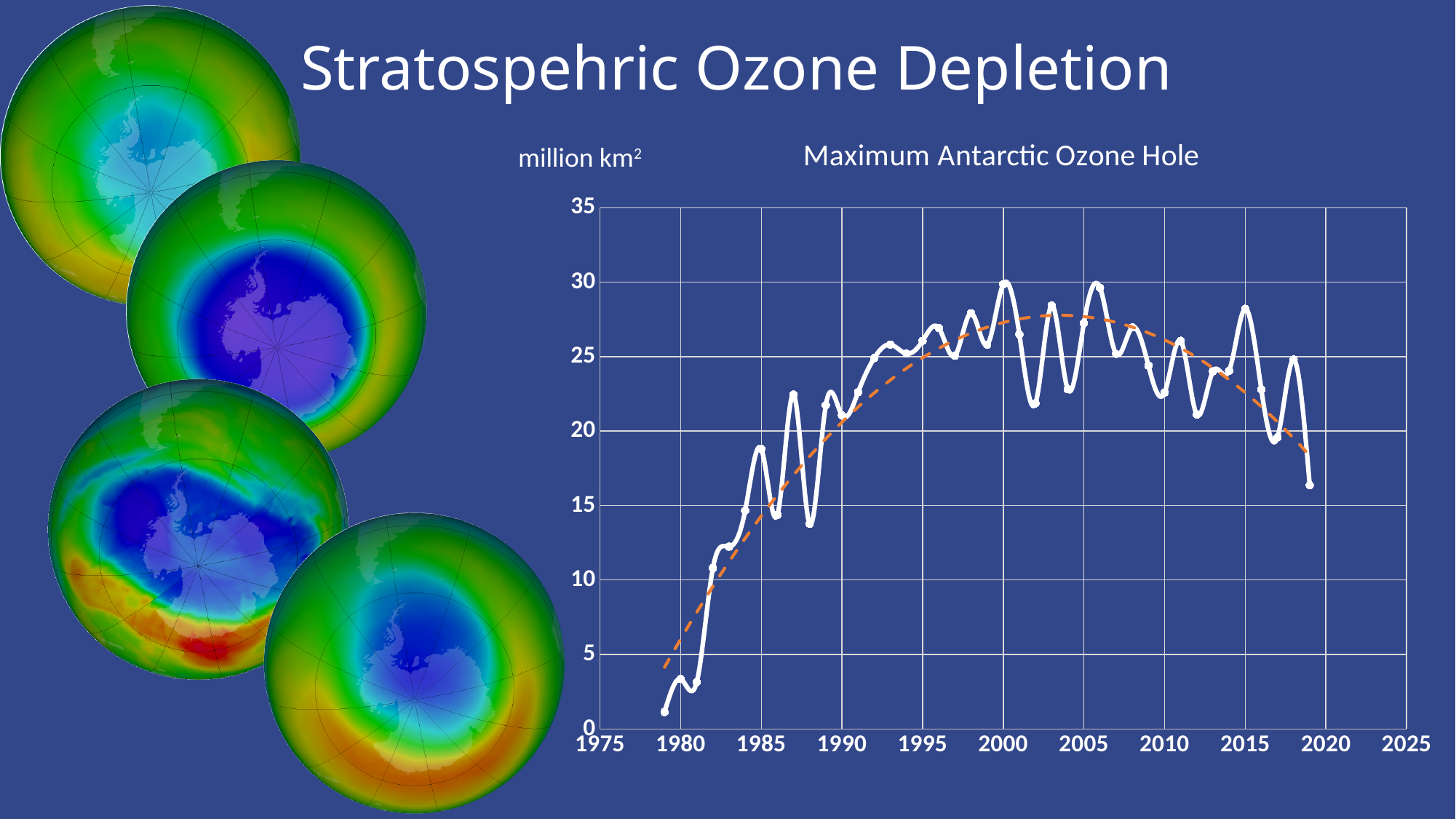
What kind of chart is shown on the slide? line chart Is the value for 1988 greater or less than 15? less Do the values generally rise or fall between 1979 and 2000? rise Is the value for 2006 greater or less than 25? greater What unit is shown for the vertical axis of the chart? million km² Is the value for 2015 greater or less than 25? greater Do the values generally rise or fall between 2006 and 2019? fall Which year has the lowest value on the chart? 1979 What is the title of the chart? Maximum Antarctic Ozone Hole